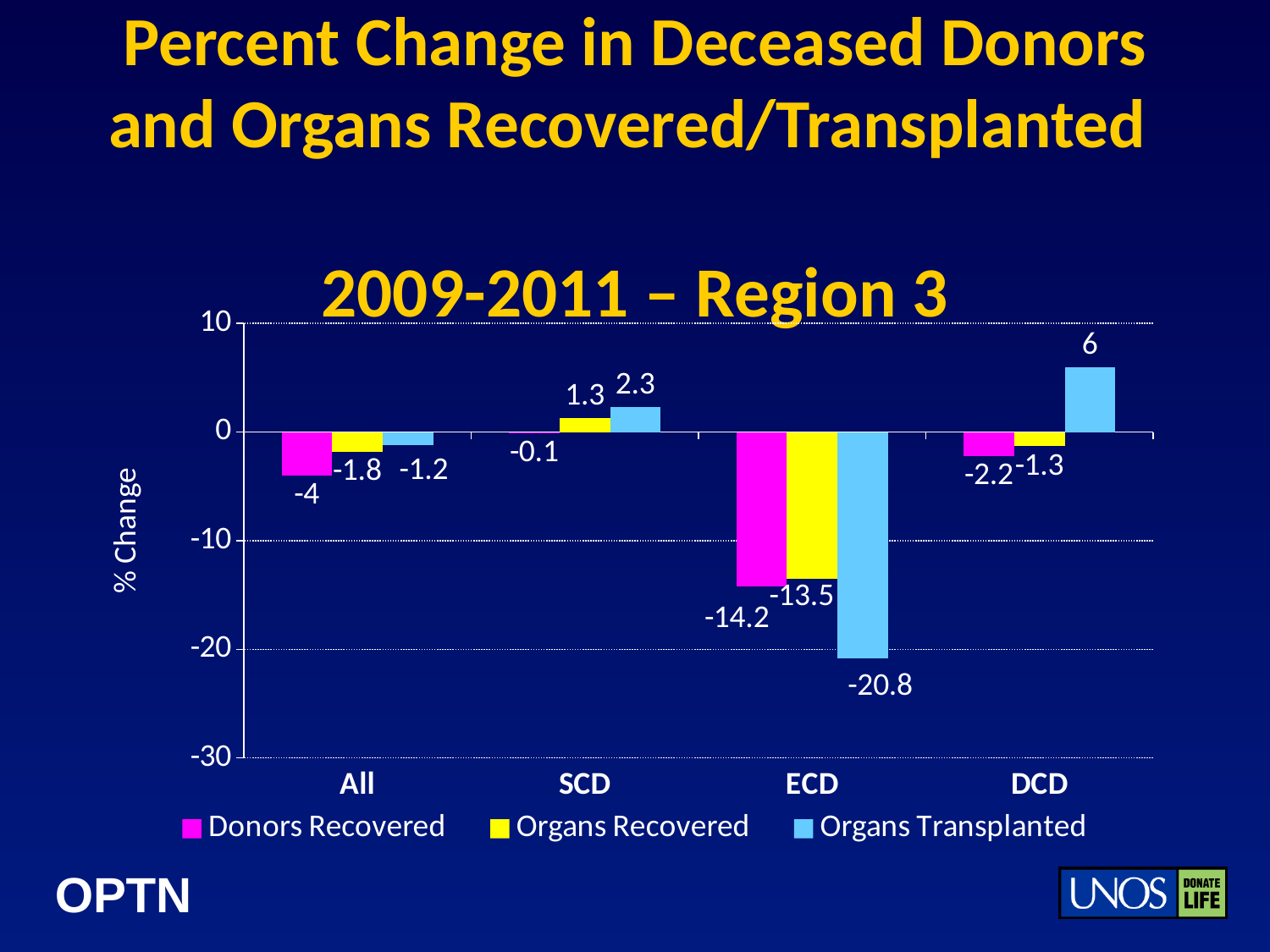
What is the percent change in Donors Recovered for ECD? -14.2 How many categories are shown on the x axis? 4 Which category has the highest value for Organs Transplanted? DCD What is the percent change in Organs Transplanted for DCD? 6 Which category has the lowest value for Organs Transplanted? ECD What is the percent change in Organs Recovered for SCD? 1.3 Which is larger for ECD: Donors Recovered or Organs Recovered? Organs Recovered What is the percent change in Donors Recovered for the All category? -4 What kind of chart is shown on the slide? Bar chart What is the title of the chart? 2009-2011 – Region 3 What is the difference between the Organs Transplanted values for DCD and ECD? 26.8 How many series does the legend list? 3